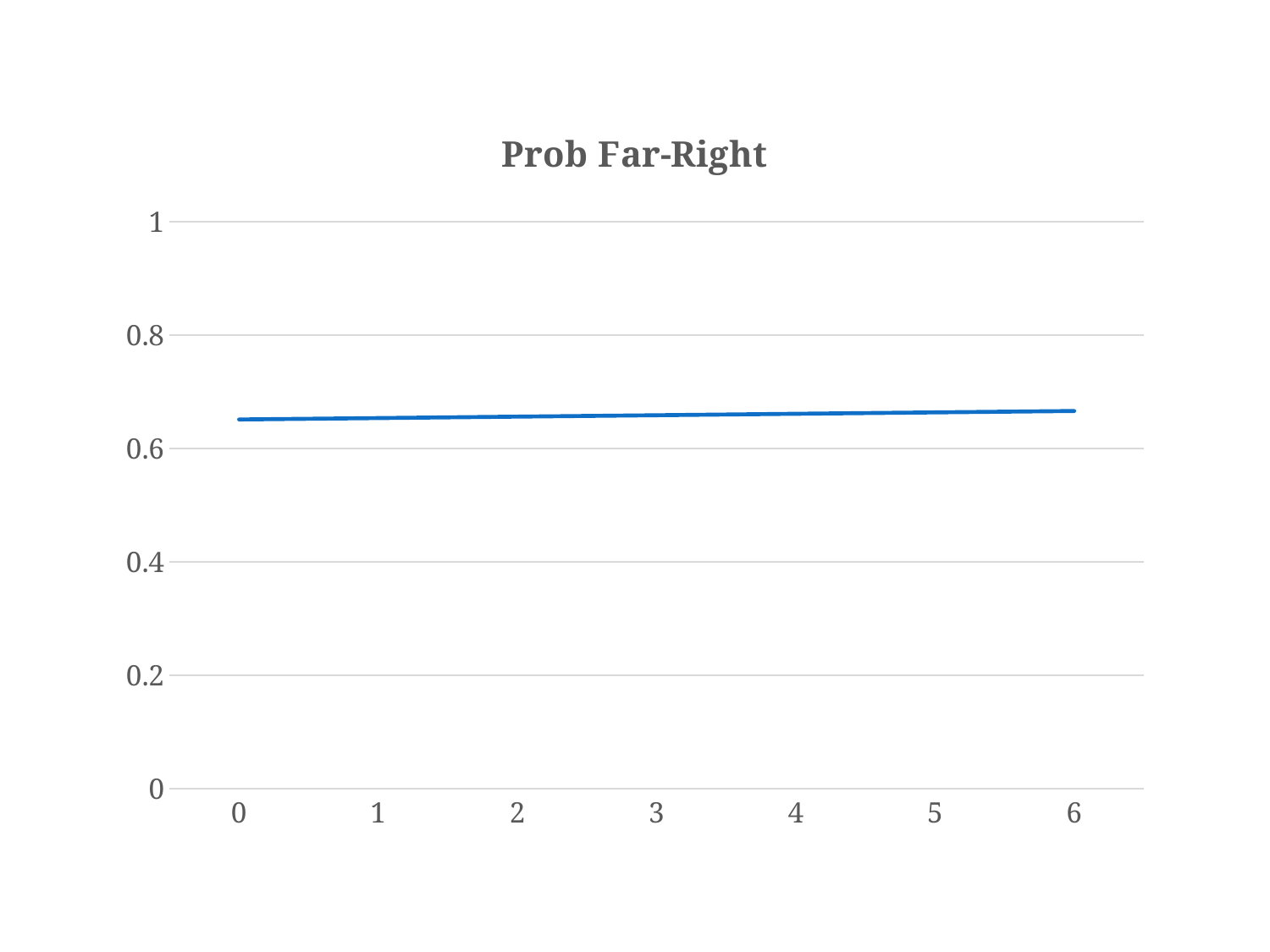
Is the value at x = 6 greater or less than 0.8? less Is the value at x = 6 greater or less than 0.6? greater Is the value at x = 3 greater or less than 0.4? greater What is the highest value shown on the y axis? 1 How many tick labels are shown on the x axis? 7 What kind of chart is shown on the slide? line chart What is the title of the chart? Prob Far-Right Do the values rise or fall as x goes from 0 to 6? rise